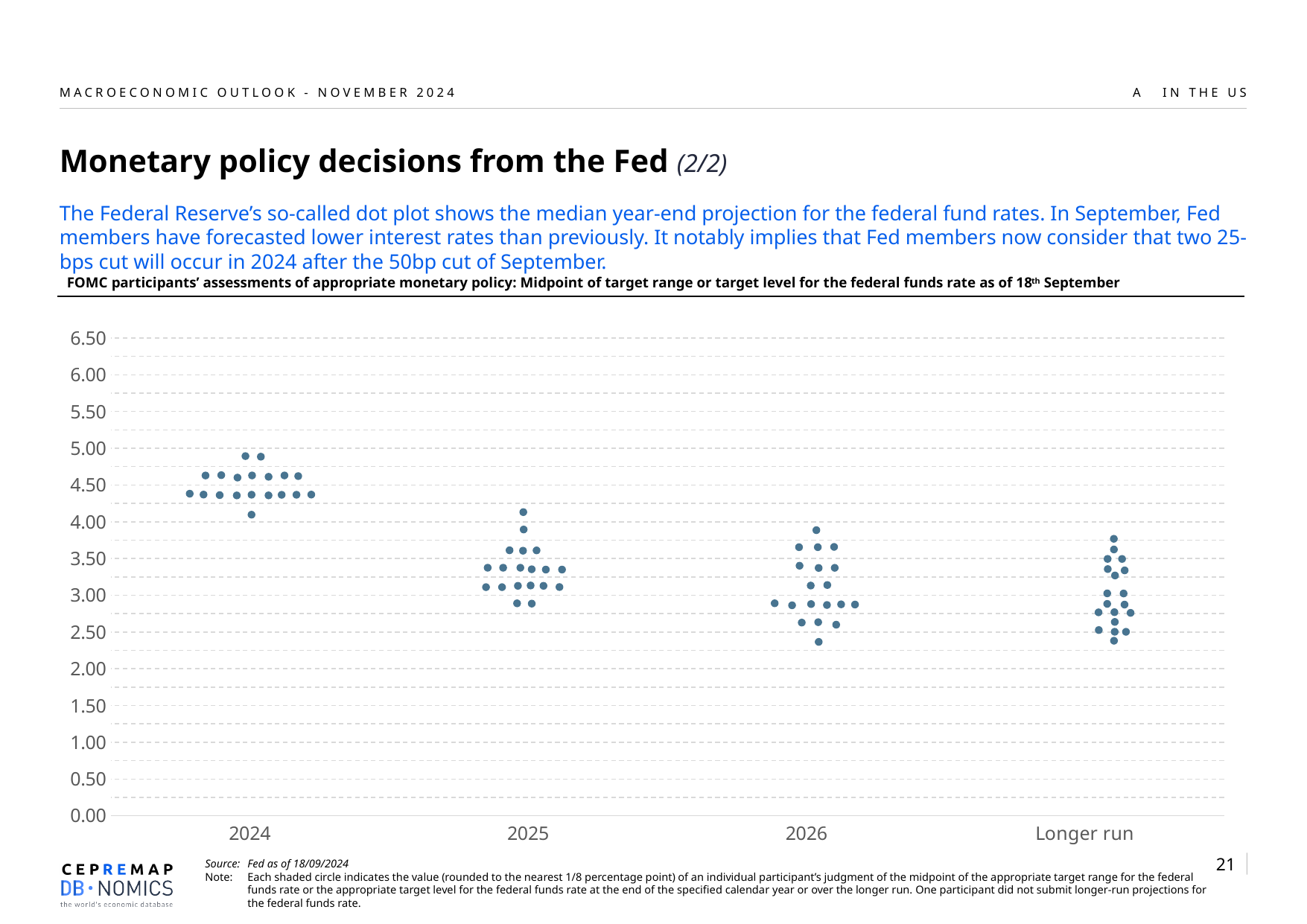
Is the highest dot for 2024 greater or less than 4.50? greater Do the dots generally rise or fall from 2024 to 2026? fall Is the lowest dot for 2025 greater or less than 3.00? less What is the highest value shown on the y axis of the chart? 6.50 What are the categories on the x axis of the chart? 2024, 2025, 2026, Longer run How many categories are shown on the x axis of the chart? 4 What kind of chart is shown on the slide? Dot plot (scatter chart) Which category has the highest dots in the chart? 2024 Is the highest dot for Longer run greater or less than 4.00? less Are the dots for 2024 higher or lower than the dots for 2025? higher